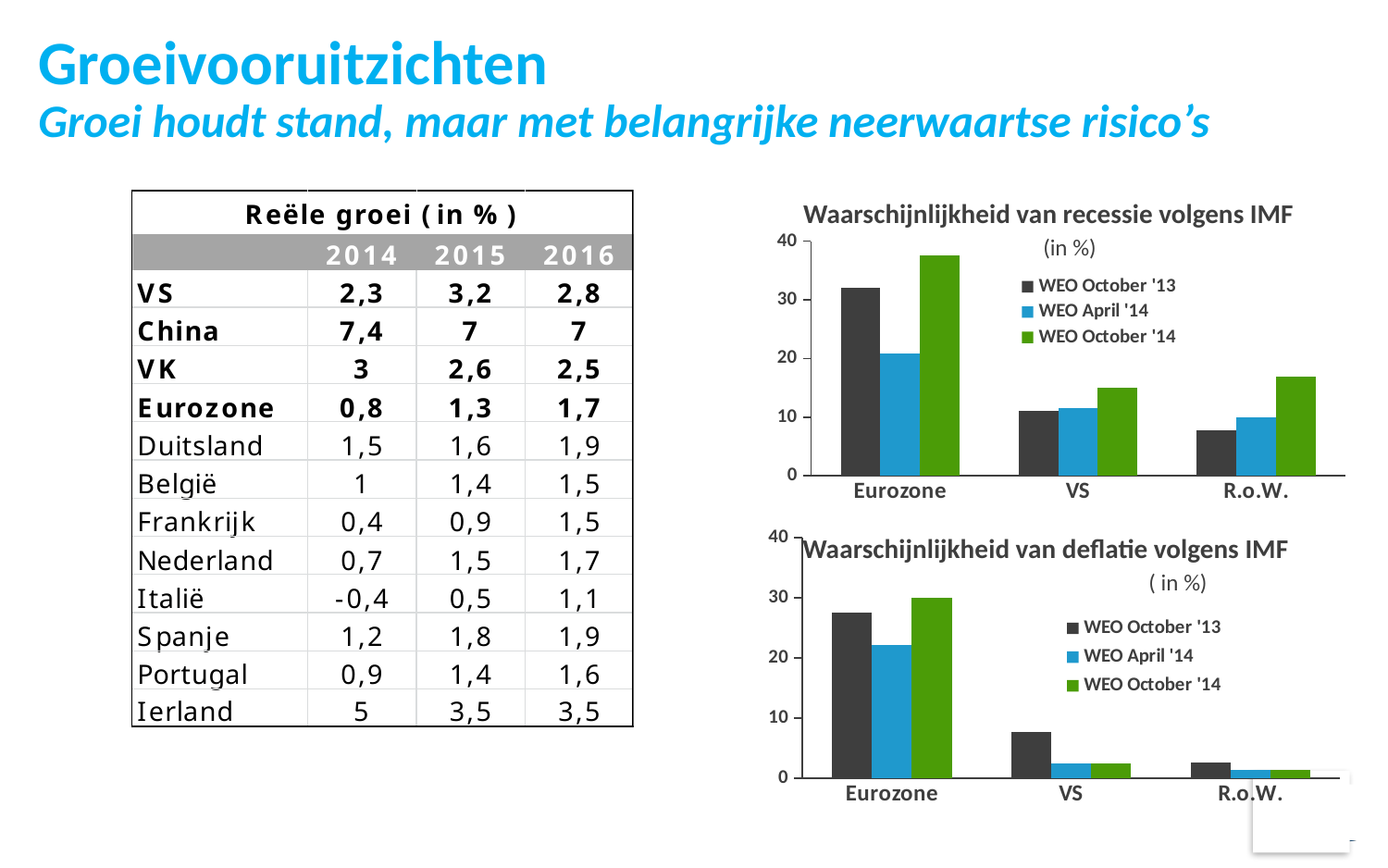
In the chart 'Waarschijnlijkheid van recessie volgens IMF', which category has the highest bar for WEO October '14? Eurozone In the chart 'Waarschijnlijkheid van deflatie volgens IMF', which category has the highest bar for WEO October '13? Eurozone How many series does the legend of the chart 'Waarschijnlijkheid van recessie volgens IMF' list? 3 In the chart 'Waarschijnlijkheid van deflatie volgens IMF', is the WEO October '14 value for Eurozone greater or less than 20? greater Which colour represents WEO April '14 in the chart 'Waarschijnlijkheid van deflatie volgens IMF'? blue How many categories are shown on the x axis of the chart 'Waarschijnlijkheid van recessie volgens IMF'? 3 In the chart 'Waarschijnlijkheid van deflatie volgens IMF', which is larger for VS: WEO October '13 or WEO April '14? WEO October '13 In the chart 'Waarschijnlijkheid van recessie volgens IMF', which is larger for R.o.W.: WEO October '13 or WEO October '14? WEO October '14 In the chart 'Waarschijnlijkheid van recessie volgens IMF', is the WEO October '14 value for Eurozone greater or less than 30? greater In the chart 'Waarschijnlijkheid van deflatie volgens IMF', is the WEO October '13 value for VS greater or less than 10? less What kind of chart is 'Waarschijnlijkheid van deflatie volgens IMF'? bar chart